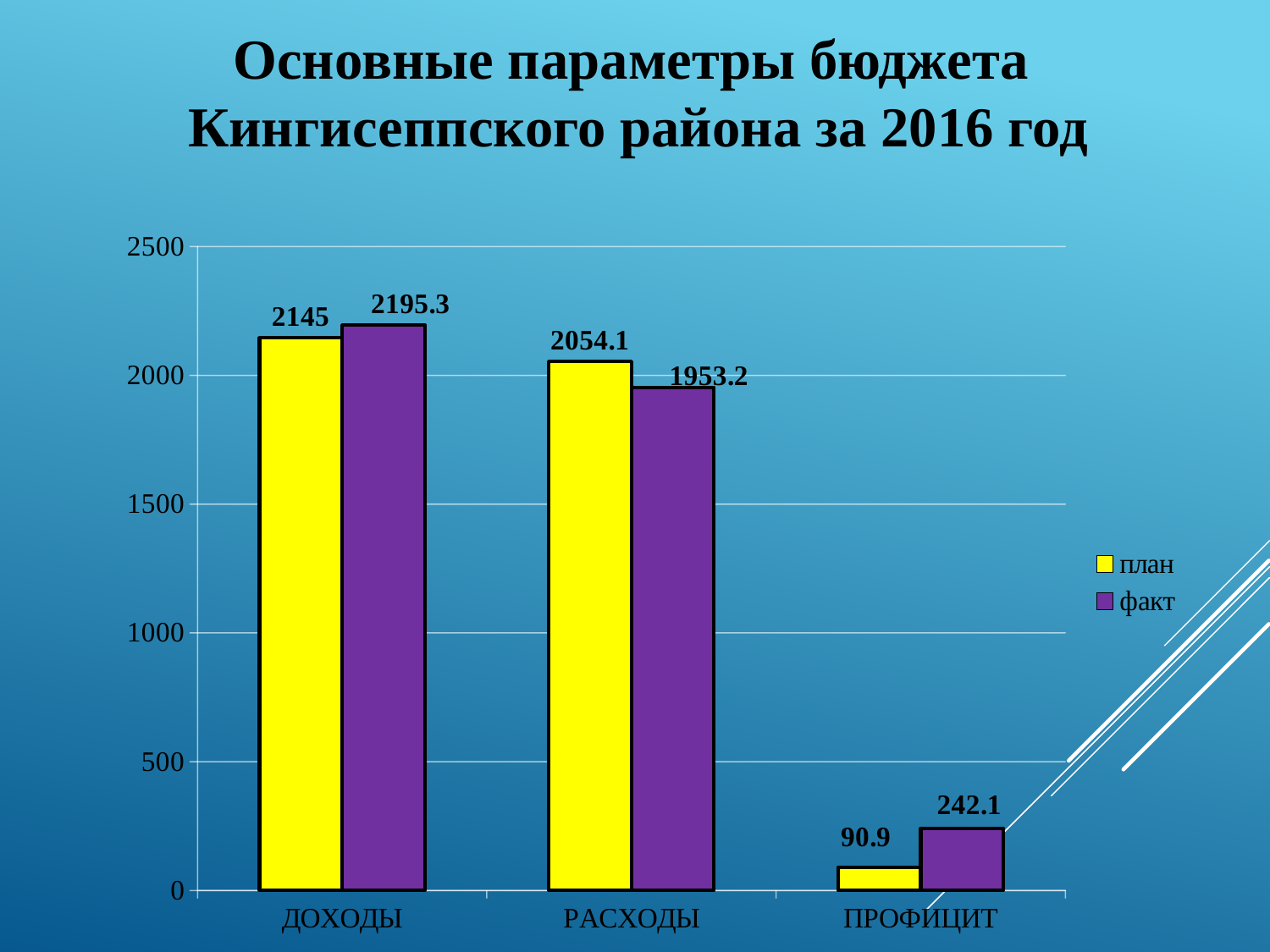
Is the план value for РАСХОДЫ greater or less than 2000? greater What is the план value for ДОХОДЫ? 2145 How many categories are shown on the x axis? 3 What is the факт value for ПРОФИЦИТ? 242.1 Which is larger for ПРОФИЦИТ, the план value or the факт value? факт What is the difference between the план and факт values for РАСХОДЫ? 100.9 How many series does the legend list? 2 Which category has the lowest план value? ПРОФИЦИТ What is the difference between the факт and план values for ДОХОДЫ? 50.3 Which category has the highest факт value? ДОХОДЫ What is the факт value for РАСХОДЫ? 1953.2 What kind of chart is shown on the slide? bar chart